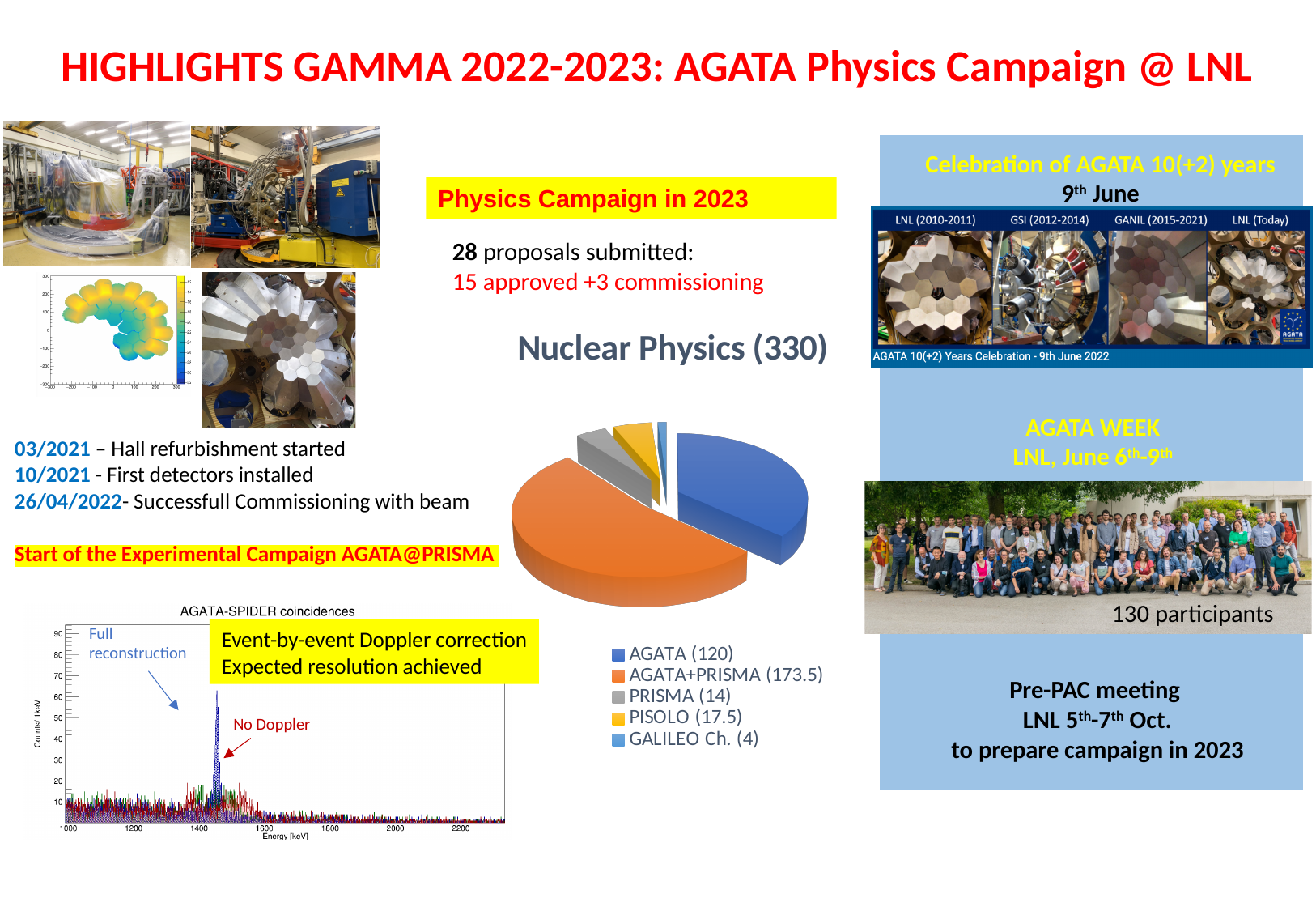
In the Nuclear Physics (330) pie chart, what colour is the AGATA+PRISMA slice? Orange In the Nuclear Physics (330) pie chart, what value is given for PISOLO? 17.5 What is the x-axis label of the AGATA-SPIDER coincidences plot at the bottom left of the slide? Energy [keV] In the Nuclear Physics (330) pie chart, which category has the smallest slice? GALILEO Ch. In the Nuclear Physics (330) pie chart, what value is given for GALILEO Ch.? 4 In the Nuclear Physics (330) pie chart, which category has the largest slice? AGATA+PRISMA In the Nuclear Physics (330) pie chart, which is larger, PRISMA or PISOLO? PISOLO In the Nuclear Physics (330) pie chart, what value is given for AGATA+PRISMA? 173.5 What kind of chart is the Nuclear Physics (330) chart? Pie chart How many categories does the Nuclear Physics (330) pie chart legend list? 5 In the Nuclear Physics (330) pie chart, what is the difference between the AGATA+PRISMA and AGATA values? 53.5 In the Nuclear Physics (330) pie chart, what is the difference between the PISOLO and PRISMA values? 3.5